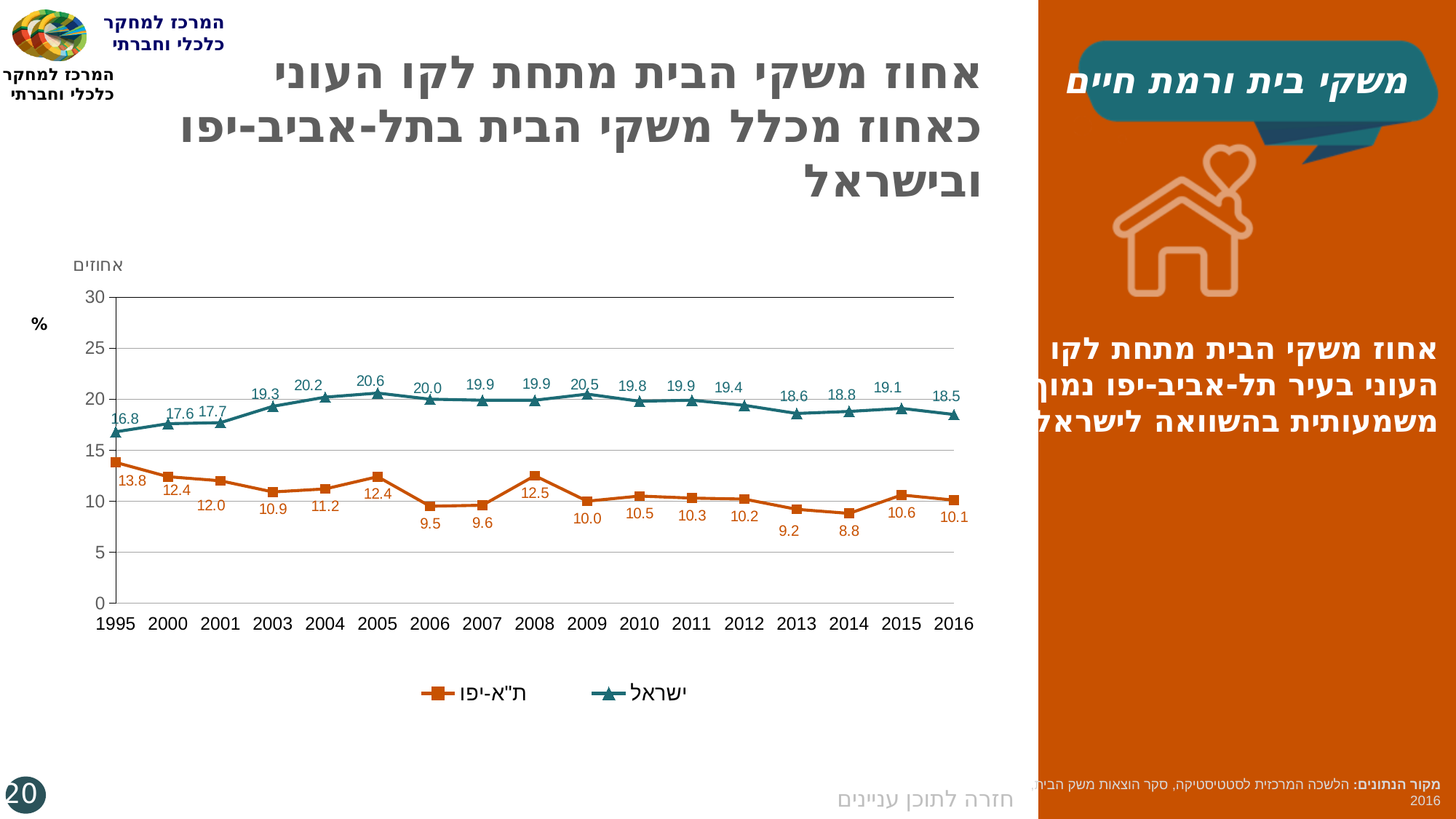
What is the difference between the ישראל and ת"א-יפו values in 2016? 8.4 What is the value for ישראל in 2005? 20.6 How many series does the legend list? 2 Which series is drawn in orange with square markers? ת"א-יפו Which series has the higher value in 2008, ישראל or ת"א-יפו? ישראל How many years are plotted along the x axis? 17 What type of chart is shown on the slide? line chart In which year is the ישראל series at its highest? 2005 What is the value for ת"א-יפו in 1995? 13.8 In which year is the ת"א-יפו series at its lowest? 2014 Is the value for ת"א-יפו in 2006 greater or less than 10? less What is the value for ת"א-יפו in 2014? 8.8